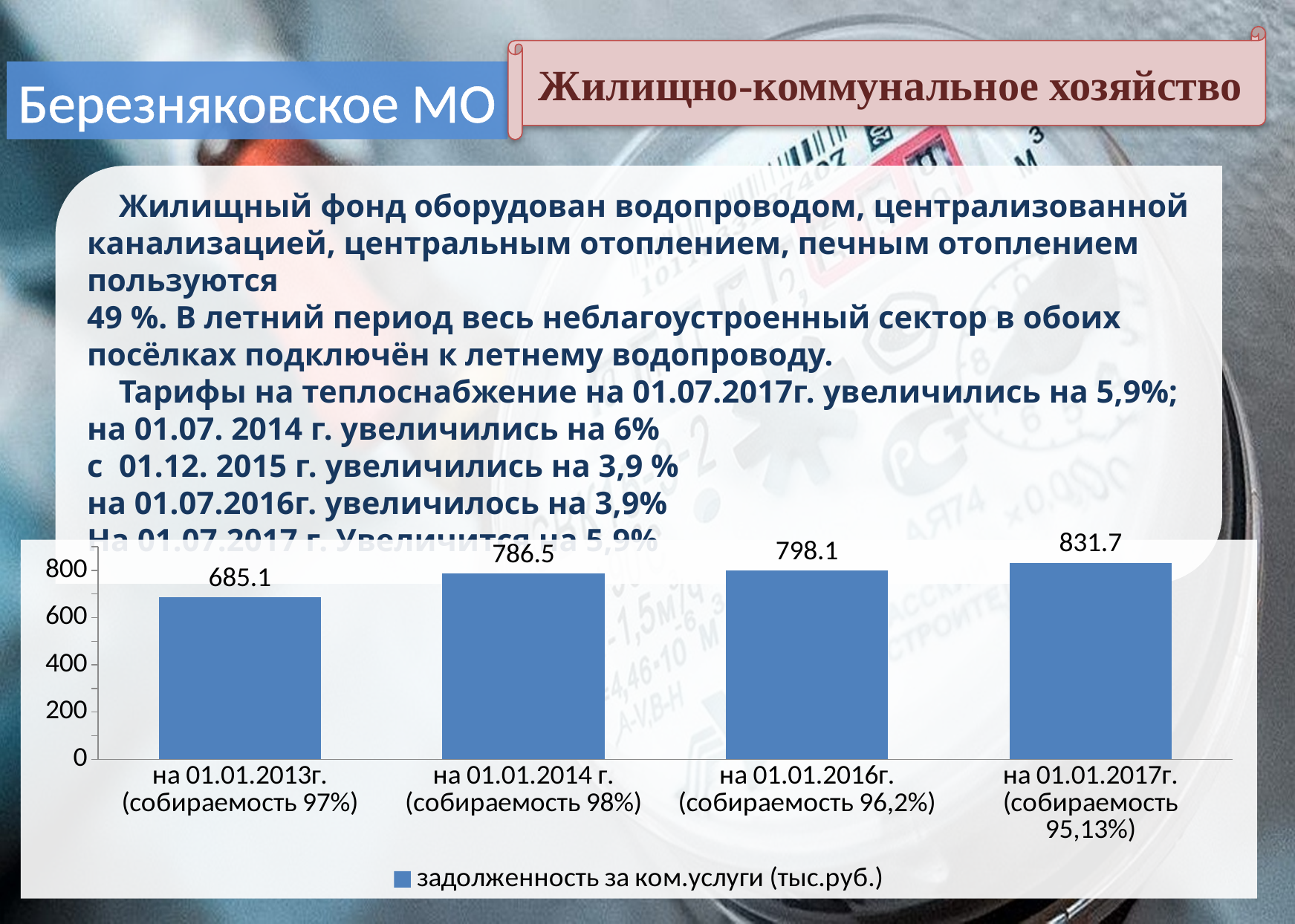
Which category has the highest value? на 01.01.2017г. (собираемость 95,13%) How many bars are shown in the chart? 4 What is the difference between the values for на 01.01.2014 г. and на 01.01.2013г.? 101.4 What is the value of the bar for на 01.01.2013г. (собираемость 97%)? 685.1 What is the value of the bar for на 01.01.2016г. (собираемость 96,2%)? 798.1 Which is larger: the value for на 01.01.2014 г. or the value for на 01.01.2013г.? на 01.01.2014 г. Do the values rise or fall from left to right along the x axis? rise What is the difference between the values for на 01.01.2017г. and на 01.01.2013г.? 146.6 What kind of chart is shown on the slide? bar chart Which category has the lowest value? на 01.01.2013г. (собираемость 97%) What is the value of the bar for на 01.01.2017г. (собираемость 95,13%)? 831.7 How many series does the legend list? 1